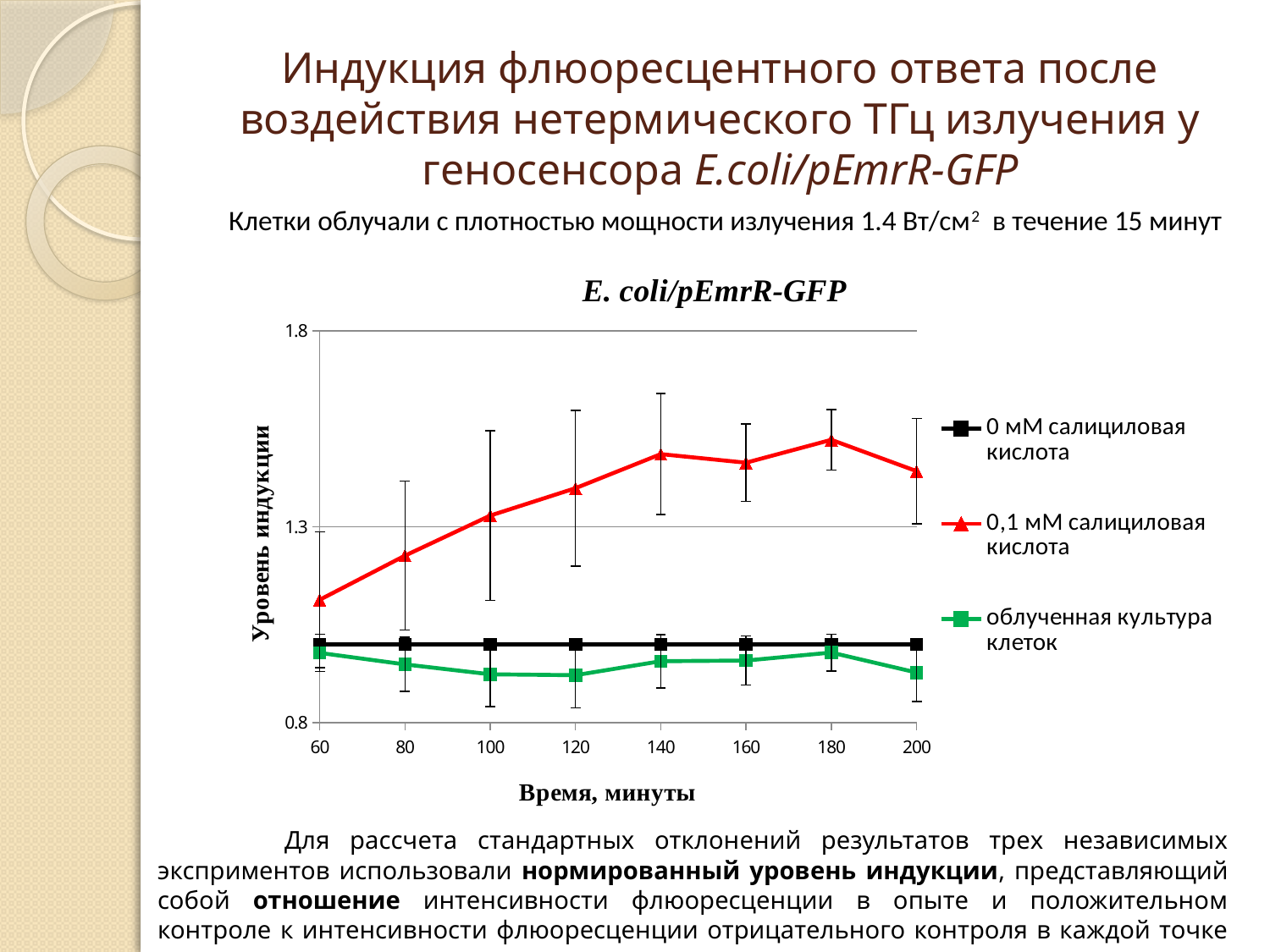
Is the value for the 0 мМ салициловая кислота series at 100 minutes greater or less than 1.3? less At which time point is the 0,1 мМ салициловая кислота series lowest? 60 Which series is drawn in red? 0,1 мМ салициловая кислота At 120 minutes, which series has the larger value: 0,1 мМ салициловая кислота or облученная культура клеток? 0,1 мМ салициловая кислота Is the value for the 0,1 мМ салициловая кислота series at 60 minutes greater or less than 1.3? less Does the 0,1 мМ салициловая кислота series generally rise or fall from 60 to 180 minutes? rise What kind of chart is shown on the slide? line chart How many series does the legend list? 3 Is the value for the 0,1 мМ салициловая кислота series at 200 minutes greater or less than 1.3? greater What is the title of the chart? E. coli/pEmrR-GFP How many time points are plotted along the x axis? 8